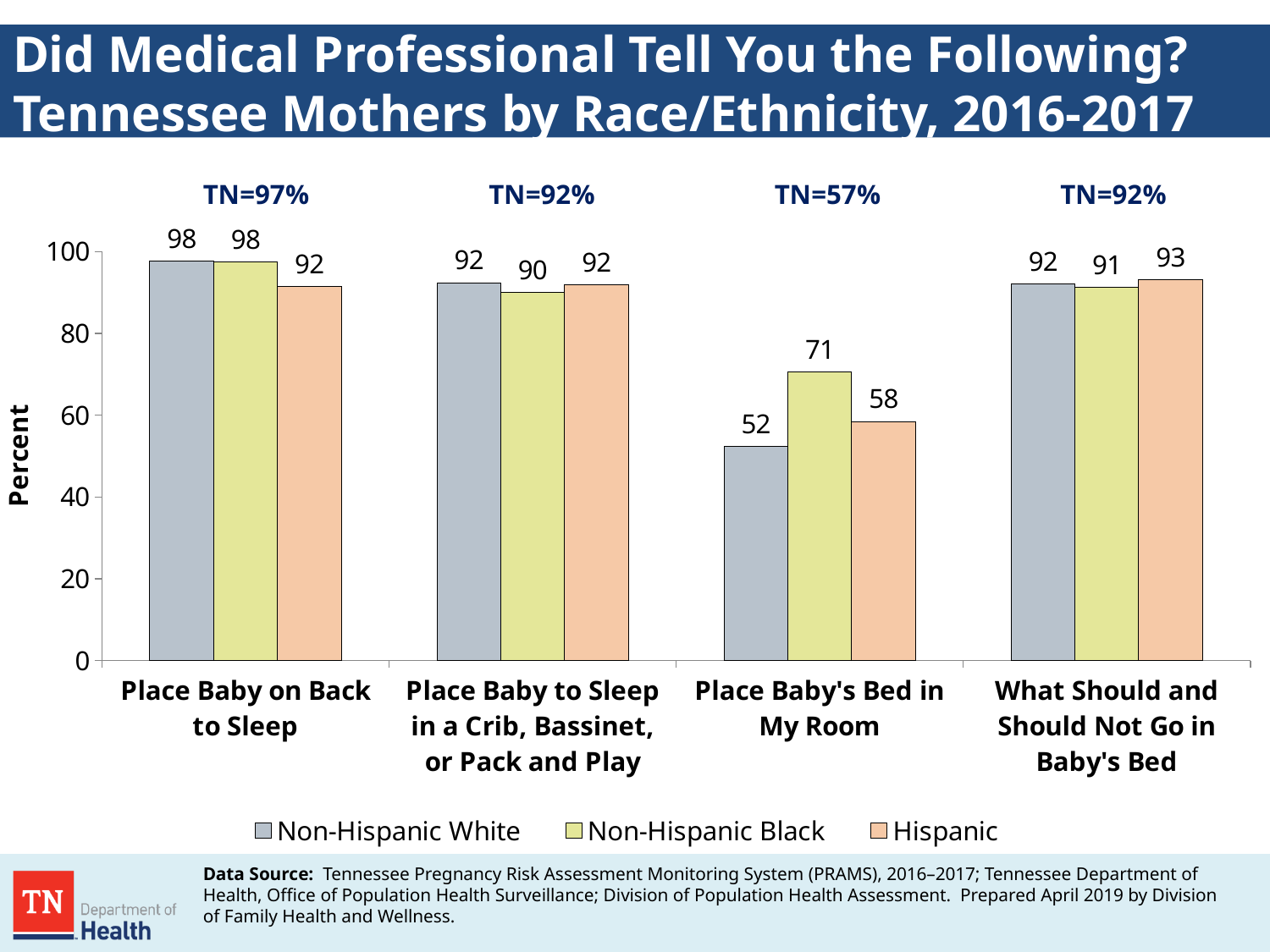
For "Place Baby's Bed in My Room", is the Hispanic value larger or the Non-Hispanic White value larger? Hispanic What is the value for Non-Hispanic White mothers for "What Should and Should Not Go in Baby's Bed"? 92 What is the difference between the Non-Hispanic White and Hispanic values for "Place Baby on Back to Sleep"? 6 What is the difference between the Non-Hispanic Black and Non-Hispanic White values for "Place Baby's Bed in My Room"? 19 What is the value for Hispanic mothers for "Place Baby to Sleep in a Crib, Bassinet, or Pack and Play"? 92 Which race/ethnicity group has the highest value for "Place Baby's Bed in My Room"? Non-Hispanic Black Which category has the lowest value for Non-Hispanic White mothers? Place Baby's Bed in My Room What is the overall Tennessee percentage shown above the "Place Baby's Bed in My Room" category? TN=57% How many series does the legend list? 3 What is the value for Non-Hispanic Black mothers for "Place Baby's Bed in My Room"? 71 What kind of chart is shown on the slide? Bar chart How many categories are shown on the x axis? 4